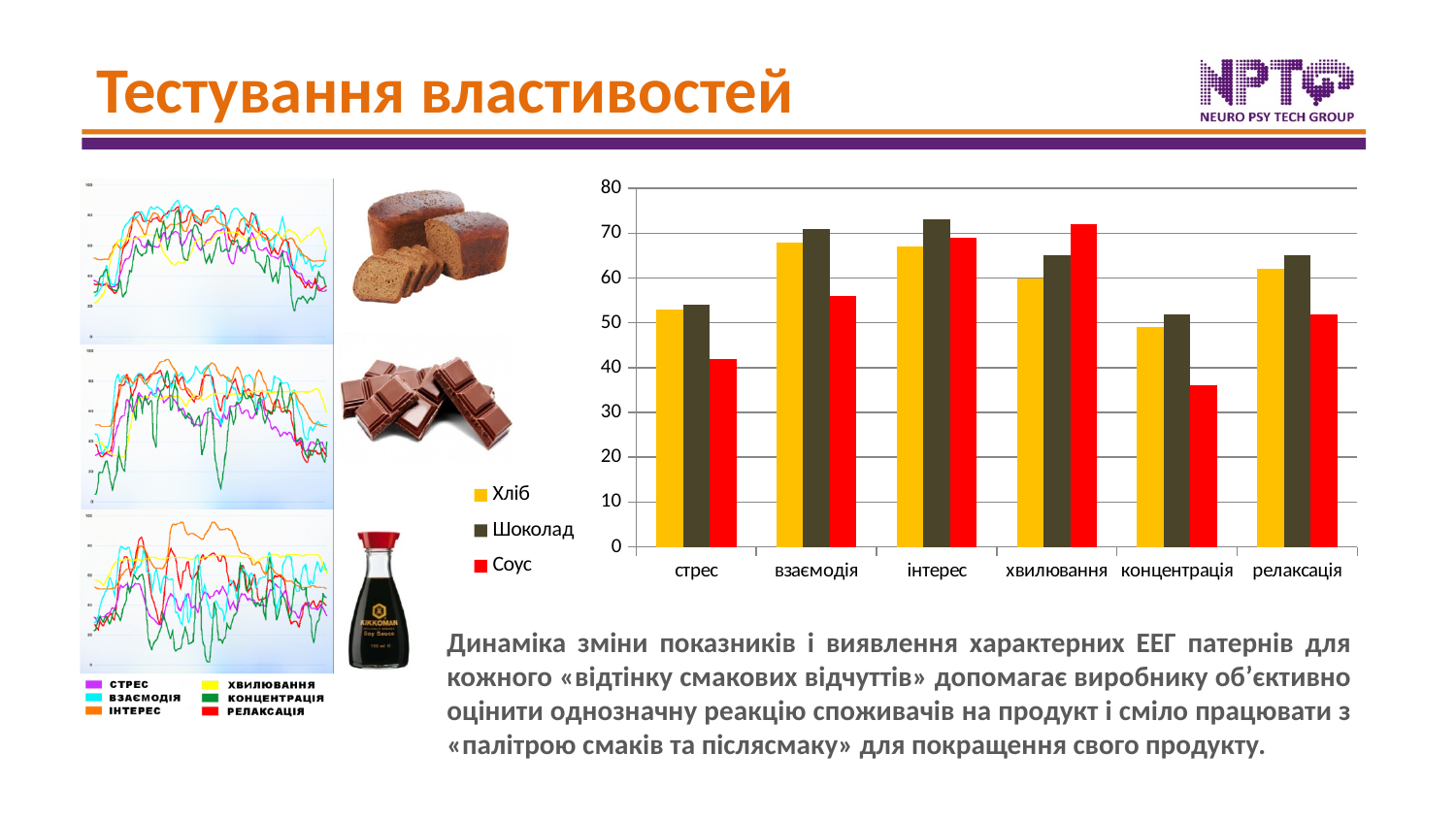
How many series does the legend of the bar chart list? 3 In the bar chart, is the value of Шоколад for релаксація greater or less than 60? greater What colour represents Соус in the bar chart legend? red In the bar chart, is the value of Соус for концентрація greater or less than 40? less In the bar chart, which is larger for хвилювання: Шоколад or Соус? Соус How many categories are shown along the x axis of the bar chart? 6 In the bar chart, which is larger for концентрація: Хліб or Соус? Хліб In the bar chart, is the value of Хліб for взаємодія greater or less than 60? greater In the bar chart, for which category is the Соус value lowest? концентрація What kind of chart is shown on the right side of the slide? bar chart In the bar chart, for which category is the Хліб value lowest? концентрація